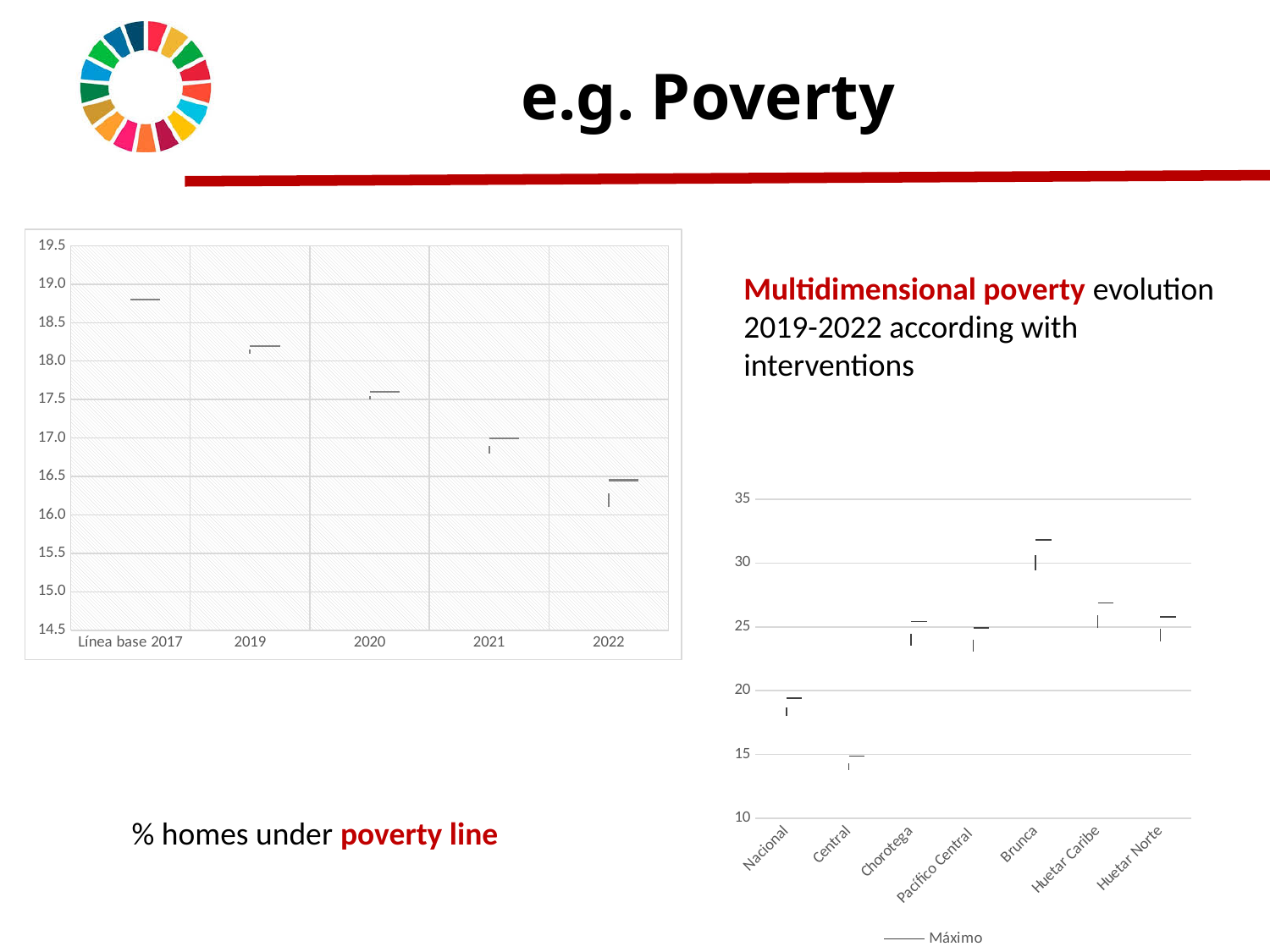
In the left chart (% homes under poverty line), is the value for 2022 greater or less than 17.0? less In the left chart (% homes under poverty line), how many categories are shown on the x axis? 5 In the right chart (multidimensional poverty by region), which region has the highest value? Brunca In the right chart (multidimensional poverty by region), is the value for Nacional greater or less than 20? less In the right chart (multidimensional poverty by region), which region has the lowest value? Central In the left chart (% homes under poverty line), which category has the highest value? Línea base 2017 In the left chart (% homes under poverty line), which category has the lowest value? 2022 In the left chart (% homes under poverty line), do the values rise or fall from Línea base 2017 to 2022? fall In the right chart (multidimensional poverty by region), how many regions are shown on the x axis? 7 In the right chart (multidimensional poverty by region), what entry does the legend list? Máximo In the left chart (% homes under poverty line), is the value for Línea base 2017 greater or less than 18.5? greater